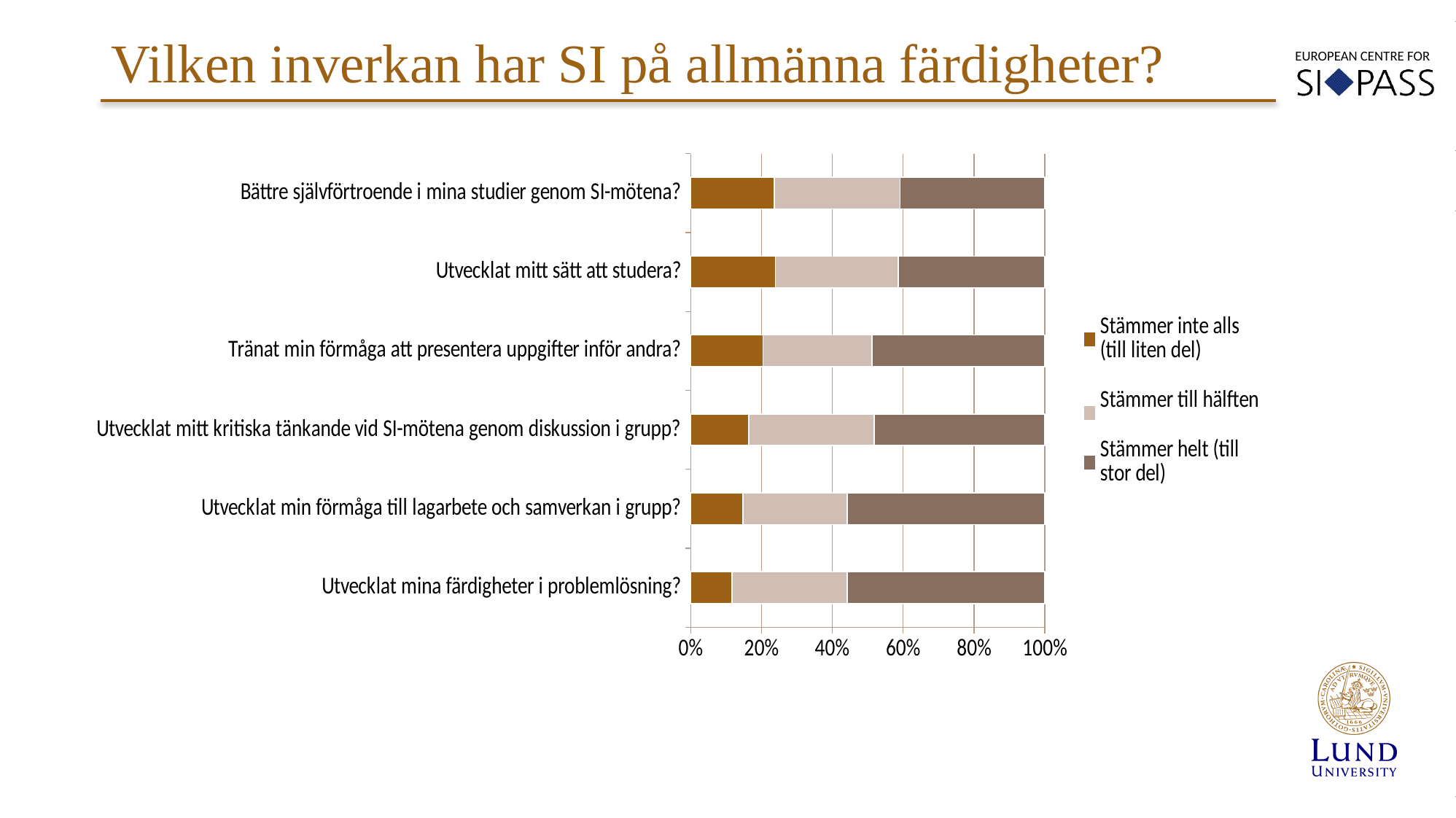
Which legend entry is shown in the darkest (grey-brown) colour? Stämmer helt (till stor del) Is the 'Stämmer inte alls (till liten del)' share for 'Bättre självförtroende i mina studier genom SI-mötena?' greater or less than 20%? greater What is the title of the slide containing the chart? Vilken inverkan har SI på allmänna färdigheter? How many series does the legend list? 3 Which has the larger 'Stämmer helt (till stor del)' share: 'Utvecklat min förmåga till lagarbete och samverkan i grupp?' or 'Bättre självförtroende i mina studier genom SI-mötena?' Utvecklat min förmåga till lagarbete och samverkan i grupp? Which has the larger 'Stämmer inte alls (till liten del)' share: 'Bättre självförtroende i mina studier genom SI-mötena?' or 'Utvecklat mina färdigheter i problemlösning?' Bättre självförtroende i mina studier genom SI-mötena? What kind of chart is shown on the slide? Stacked bar chart How many categories (statements) are plotted in the chart? 6 Is the 'Stämmer inte alls (till liten del)' share for 'Utvecklat mina färdigheter i problemlösning?' greater or less than 20%? less What is the highest tick value shown on the x axis? 100% What value does each stacked bar reach on the x axis? 100% Is the 'Stämmer helt (till stor del)' share for 'Utvecklat min förmåga till lagarbete och samverkan i grupp?' greater or less than 40%? greater